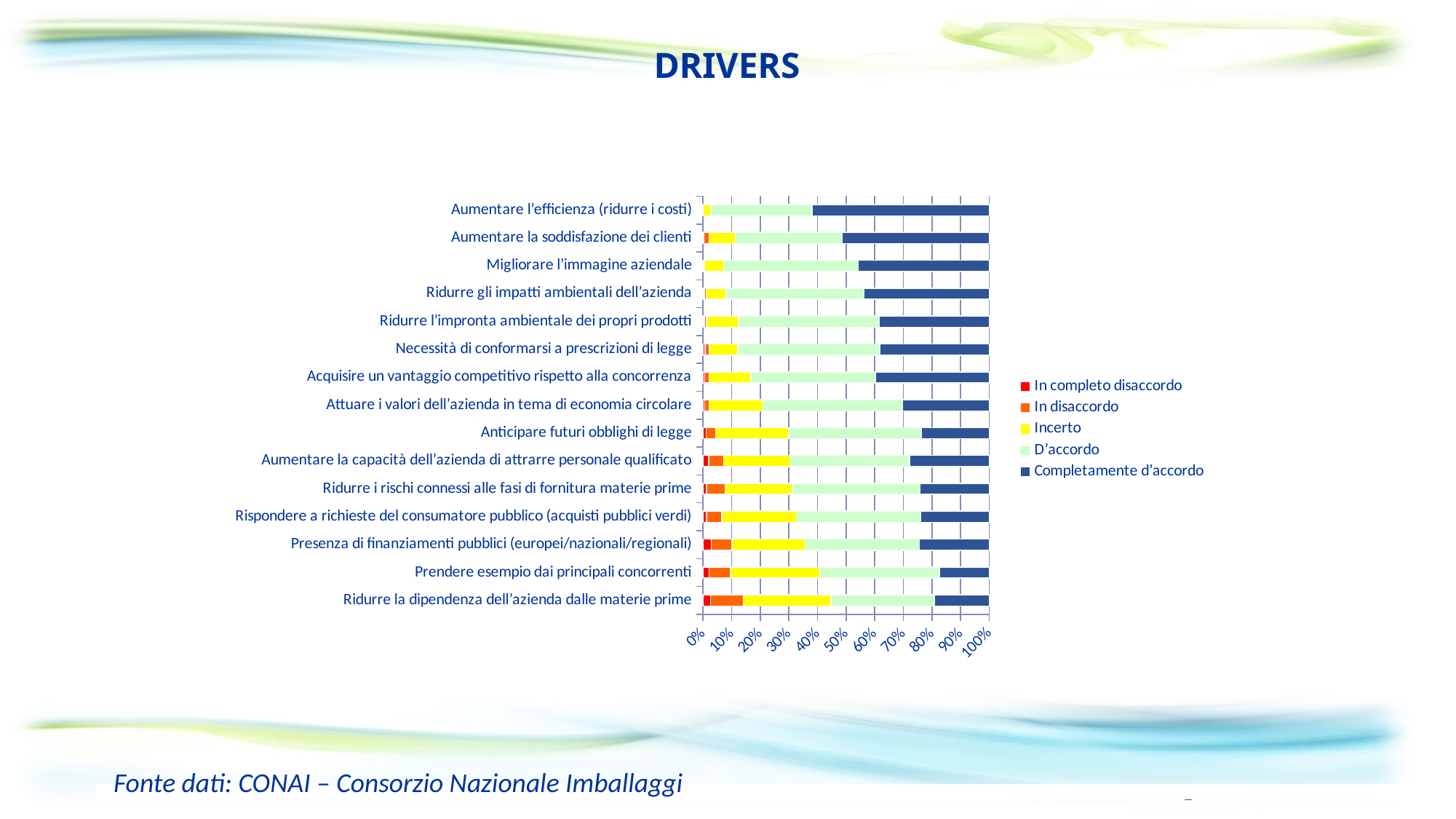
Which category has the largest 'Completamente d'accordo' segment? Aumentare l'efficienza (ridurre i costi) Which legend entry is shown in dark blue? Completamente d'accordo Which category has the largest 'In disaccordo' segment? Ridurre la dipendenza dell'azienda dalle materie prime What is the title of the slide containing the chart? DRIVERS Is the 'Incerto' share for 'Aumentare l'efficienza (ridurre i costi)' greater or less than 10%? less How many series does the chart legend list? 5 What kind of chart is shown on the slide? Stacked bar chart Is the 'Completamente d'accordo' share for 'Aumentare l'efficienza (ridurre i costi)' greater or less than 50%? greater Is the 'Completamente d'accordo' share for 'Ridurre la dipendenza dell'azienda dalle materie prime' greater or less than 30%? less Going down the list of categories from top to bottom, does the 'Completamente d'accordo' share generally increase or decrease? decrease How many categories (drivers) are listed on the chart? 15 Which has a larger 'Completamente d'accordo' share: 'Aumentare l'efficienza (ridurre i costi)' or 'Ridurre la dipendenza dell'azienda dalle materie prime'? Aumentare l'efficienza (ridurre i costi)